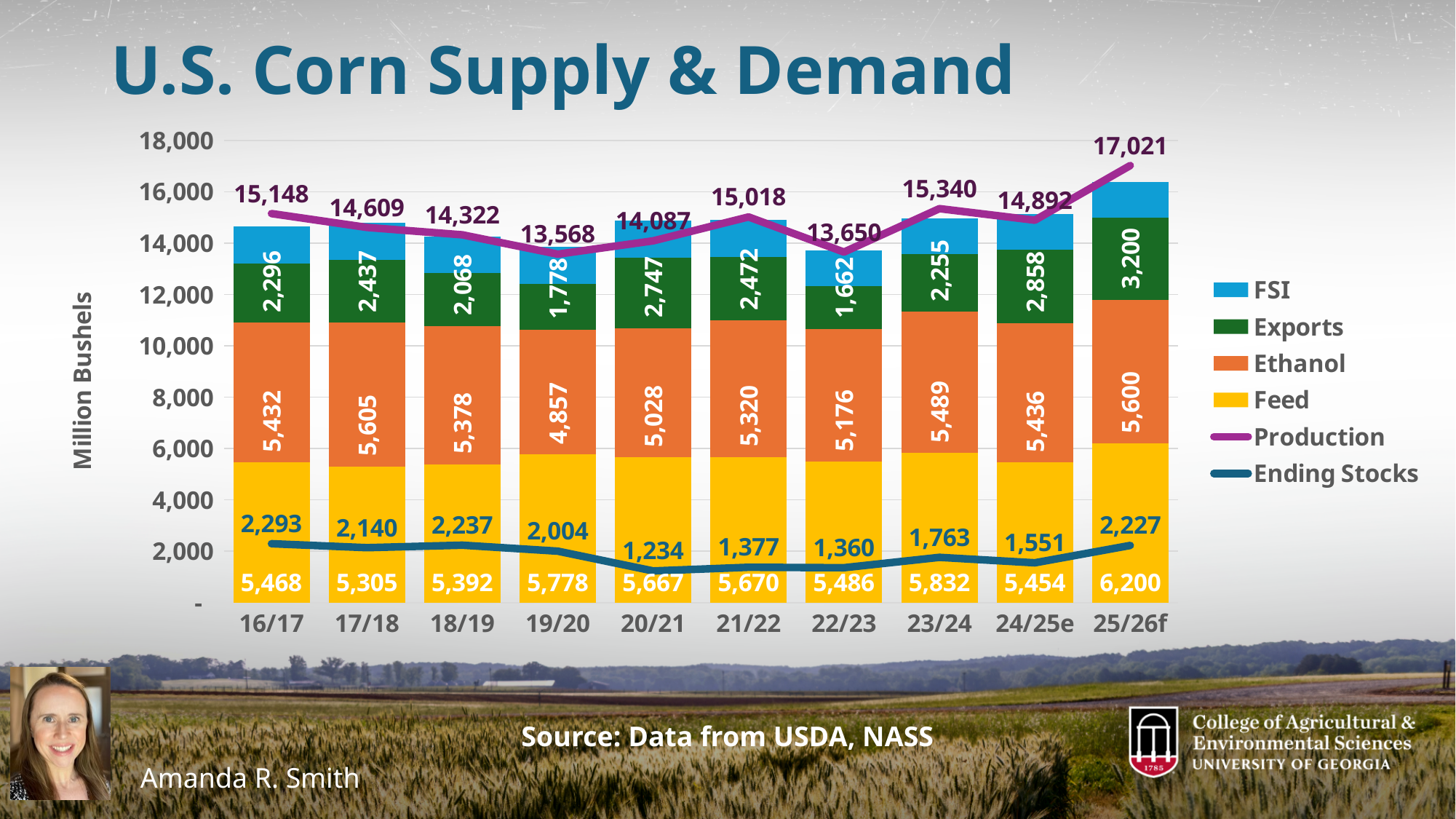
Which is larger, the Ending Stocks value for 16/17 or for 25/26f? 16/17 What is the Production value for 25/26f? 17,021 How many years are shown on the x axis? 10 Which series is shown in purple? Production What is the Ethanol value for 19/20? 4,857 How many series does the legend list? 6 Which year has the highest Production value? 25/26f What is the difference between the Feed values for 25/26f and 24/25e? 746 Which year has the lowest Exports value? 22/23 What kind of chart is this? Stacked bar chart with line series What is the Ending Stocks value for 20/21? 1,234 What is the Exports value for 24/25e? 2,858